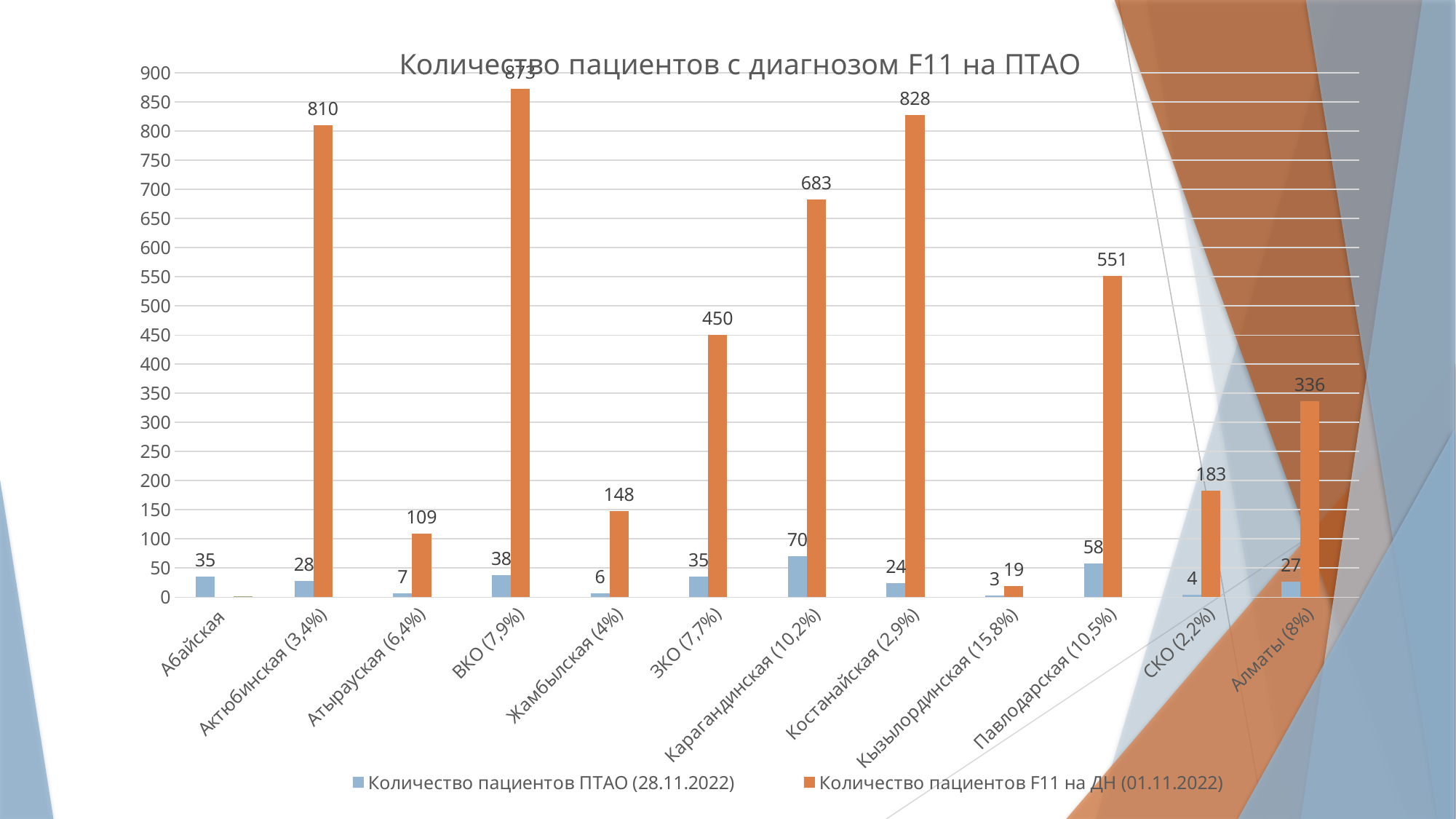
Which is larger in the series Количество пациентов F11 на ДН (01.11.2022): ЗКО (7,7%) or Алматы (8%)? ЗКО (7,7%) How many categories are shown on the x axis? 12 Is the value for СКО (2,2%) in the series Количество пациентов F11 на ДН (01.11.2022) greater or less than 200? less How many series does the legend list? 2 What is the difference between the values for Костанайская (2,9%) and Карагандинская (10,2%) in the series Количество пациентов F11 на ДН (01.11.2022)? 145 What kind of chart is shown on the slide? bar chart Which category has the highest value in the series Количество пациентов ПТАО (28.11.2022)? Карагандинская (10,2%) Which category has the lowest value in the series Количество пациентов ПТАО (28.11.2022)? Кызылординская (15,8%) What is the title of the chart? Количество пациентов с диагнозом F11 на ПТАО What is the value for Павлодарская (10,5%) in the series Количество пациентов F11 на ДН (01.11.2022)? 551 What is the value for Актюбинская (3,4%) in the series Количество пациентов F11 на ДН (01.11.2022)? 810 What is the value for Карагандинская (10,2%) in the series Количество пациентов ПТАО (28.11.2022)? 70